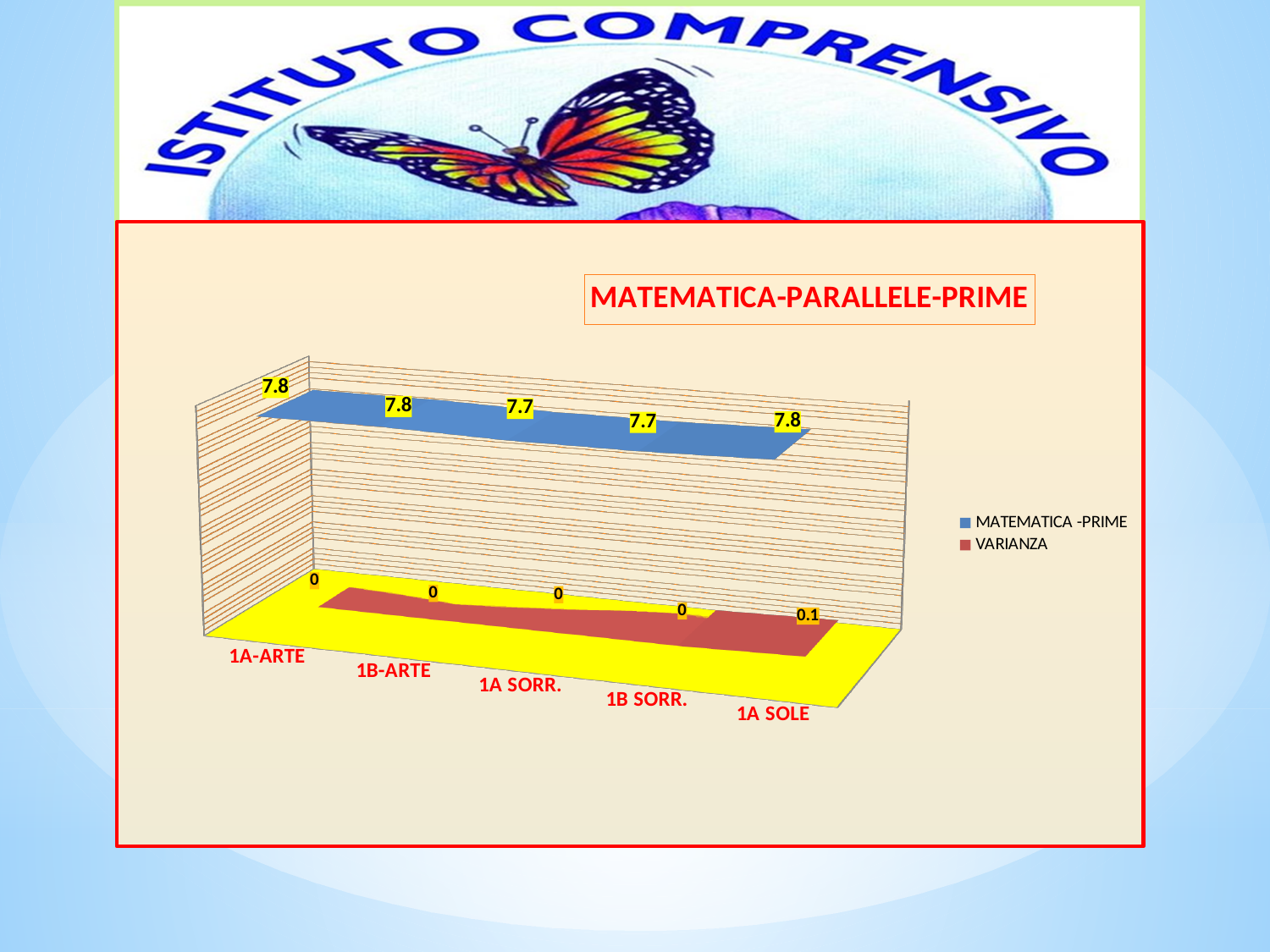
What is the title of the chart? MATEMATICA-PARALLELE-PRIME What is the difference between the MATEMATICA -PRIME values for 1B-ARTE and 1B SORR.? 0.1 What is the VARIANZA value for 1B-ARTE? 0 What is the VARIANZA value for 1A SOLE? 0.1 What kind of chart is shown on the slide? 3D line chart Which is larger, the MATEMATICA -PRIME value for 1A SOLE or for 1B SORR.? 1A SOLE Which series is shown in blue in the legend? MATEMATICA -PRIME What is the MATEMATICA -PRIME value for 1A-ARTE? 7.8 How many series does the legend list? 2 How many categories are shown along the x axis? 5 Which category has the highest VARIANZA value? 1A SOLE What is the MATEMATICA -PRIME value for 1A SORR.? 7.7